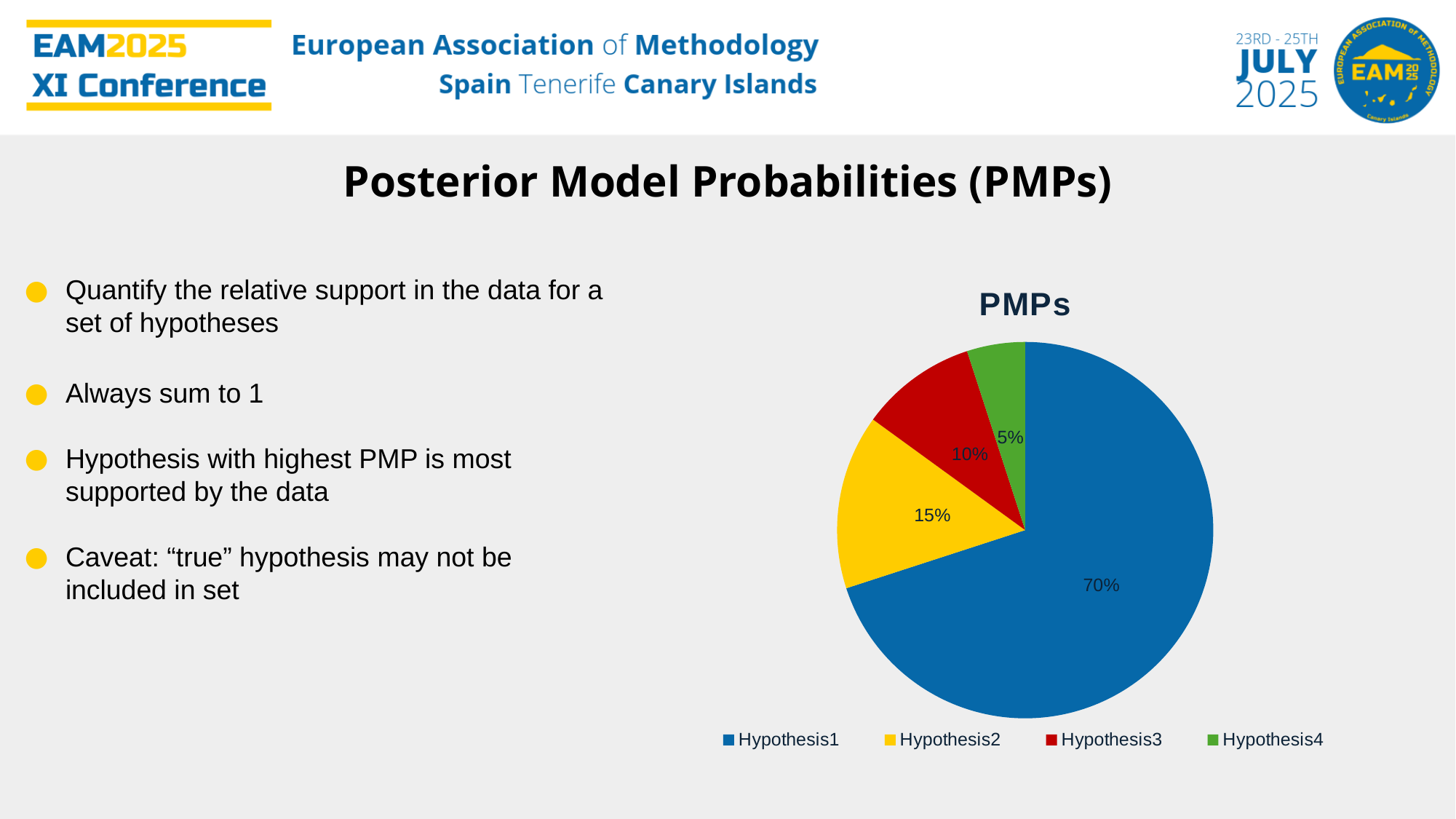
What share of the pie does Hypothesis4 have? 5% Which colour represents Hypothesis2 in the legend? yellow What share of the pie does Hypothesis3 have? 10% What share of the pie does Hypothesis2 have? 15% What share of the pie does Hypothesis1 have? 70% Which hypothesis has the smallest slice of the pie? Hypothesis4 Which has a larger share, Hypothesis3 or Hypothesis4? Hypothesis3 Which hypothesis has the largest slice of the pie? Hypothesis1 How many slices does the pie chart have? 4 What kind of chart is shown on the slide? pie chart What is the title of the chart? PMPs What is the difference between the shares of Hypothesis1 and Hypothesis2? 55%